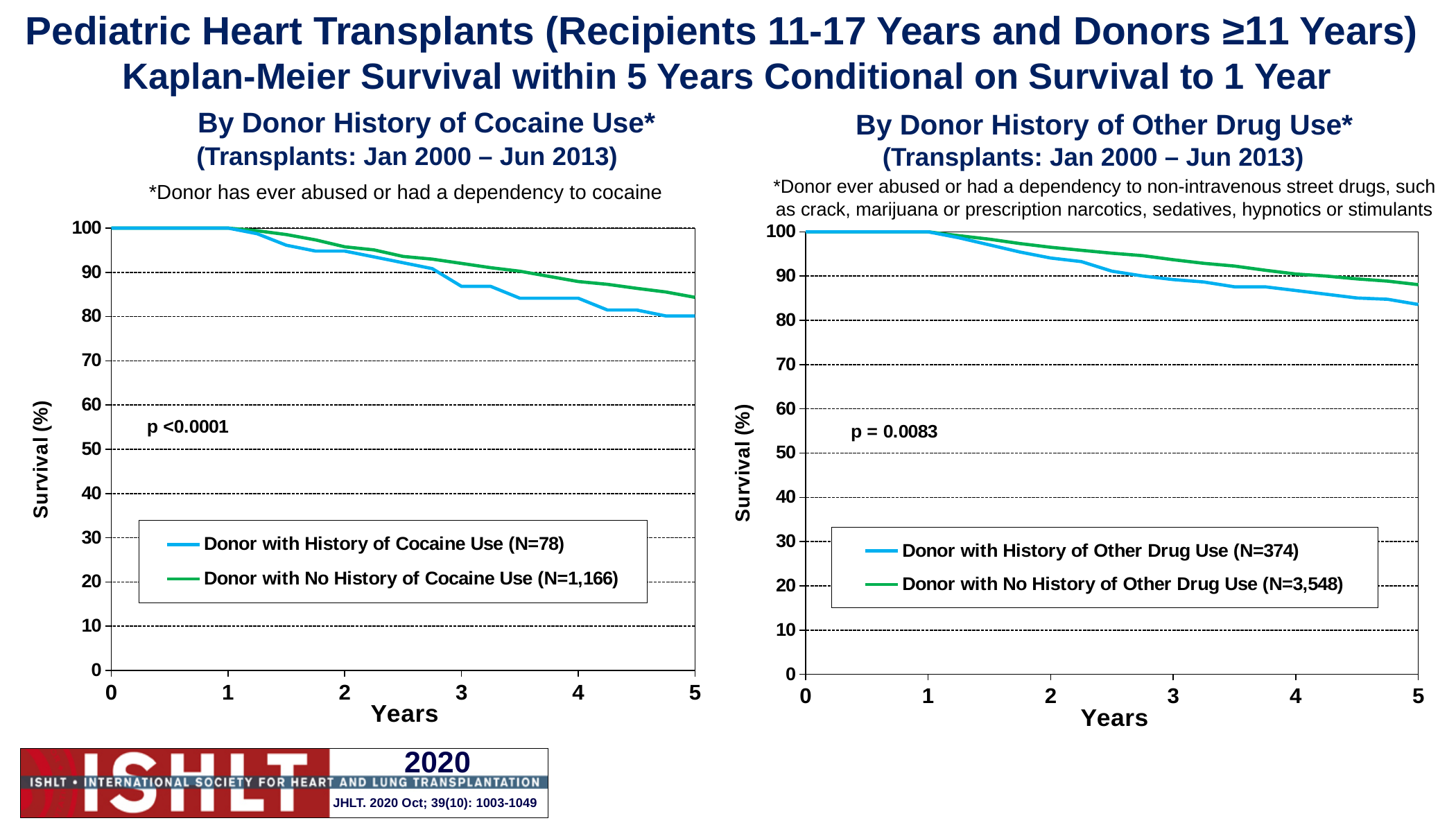
In the 'By Donor History of Other Drug Use' chart, is the survival value for Donor with History of Other Drug Use at year 5 greater or less than 90? less What is the N for the Donor with History of Other Drug Use series in the right chart's legend? N=374 In the 'By Donor History of Cocaine Use' chart, is the survival value for Donor with No History of Cocaine Use at year 5 greater or less than 80? greater In the 'By Donor History of Other Drug Use' chart, what is the survival value for both series at year 1? 100 In the 'By Donor History of Cocaine Use' chart, which series has the higher survival at year 5? Donor with No History of Cocaine Use (N=1,166) In the 'By Donor History of Cocaine Use' chart, is the survival value for Donor with History of Cocaine Use at year 4 greater or less than 90? less How many series does the legend of the 'By Donor History of Other Drug Use' chart list? 2 What p-value is shown on the 'By Donor History of Cocaine Use' chart? p <0.0001 In the 'By Donor History of Cocaine Use' chart, what is the survival value for both series at year 0? 100 In the 'By Donor History of Other Drug Use' chart, does survival rise or fall from year 1 to year 5? fall What kind of chart is the 'By Donor History of Cocaine Use' chart on the left? line chart